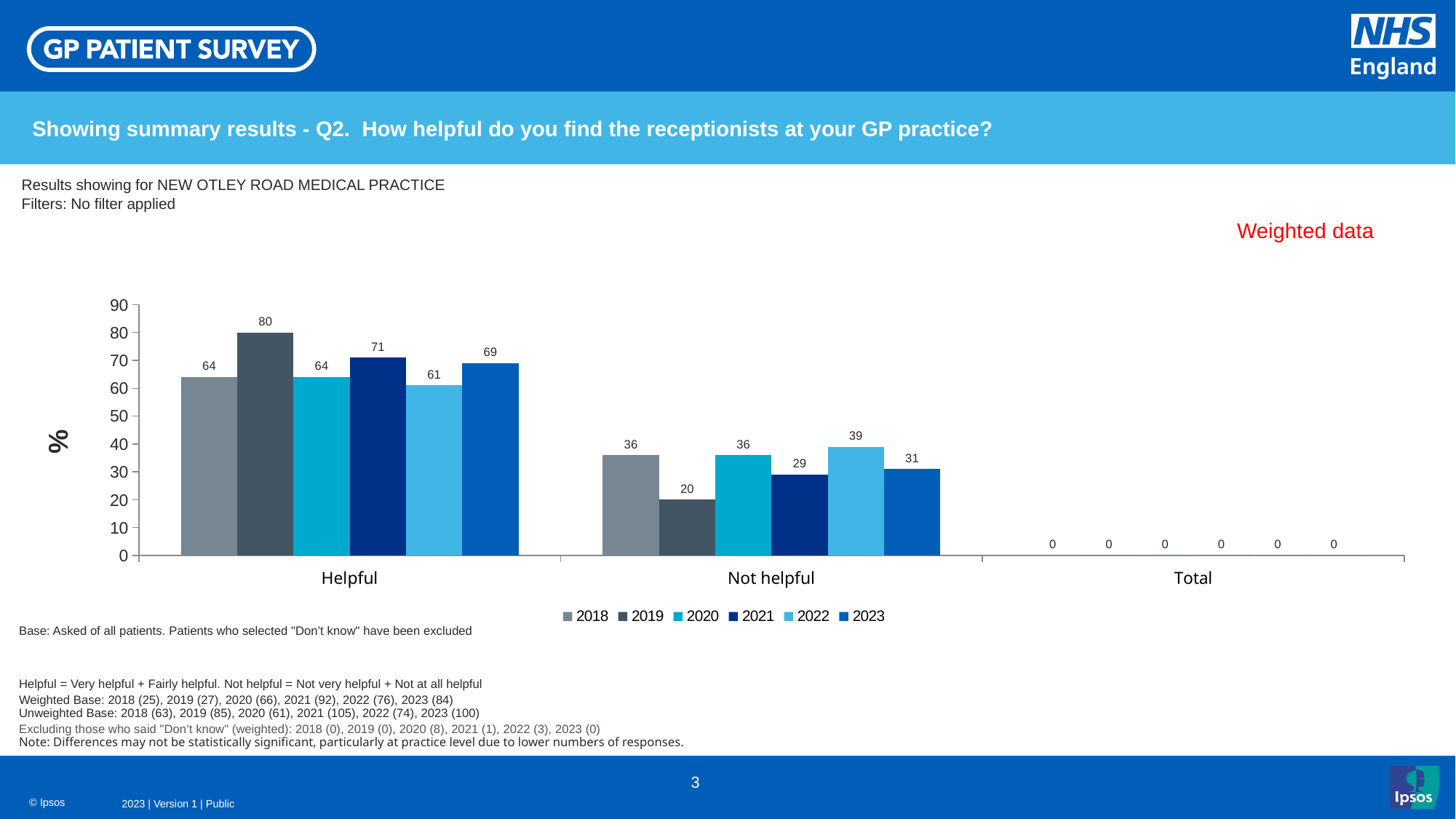
Is the value for 2018 in the Not helpful category greater or less than 30? greater Which is larger in the Not helpful category: the value for 2021 or the value for 2023? 2023 What is the difference between the 2019 and 2022 values in the Helpful category? 19 Which year has the lowest value in the Not helpful category? 2019 What is the label on the vertical axis of the chart? % Which year has the highest value in the Helpful category? 2019 What kind of chart is shown on the slide? bar chart What is the value for 2019 in the Helpful category? 80 How many series does the legend list? 6 What is the value for 2022 in the Not helpful category? 39 What is the value for 2023 in the Helpful category? 69 How many categories are shown on the x axis? 3